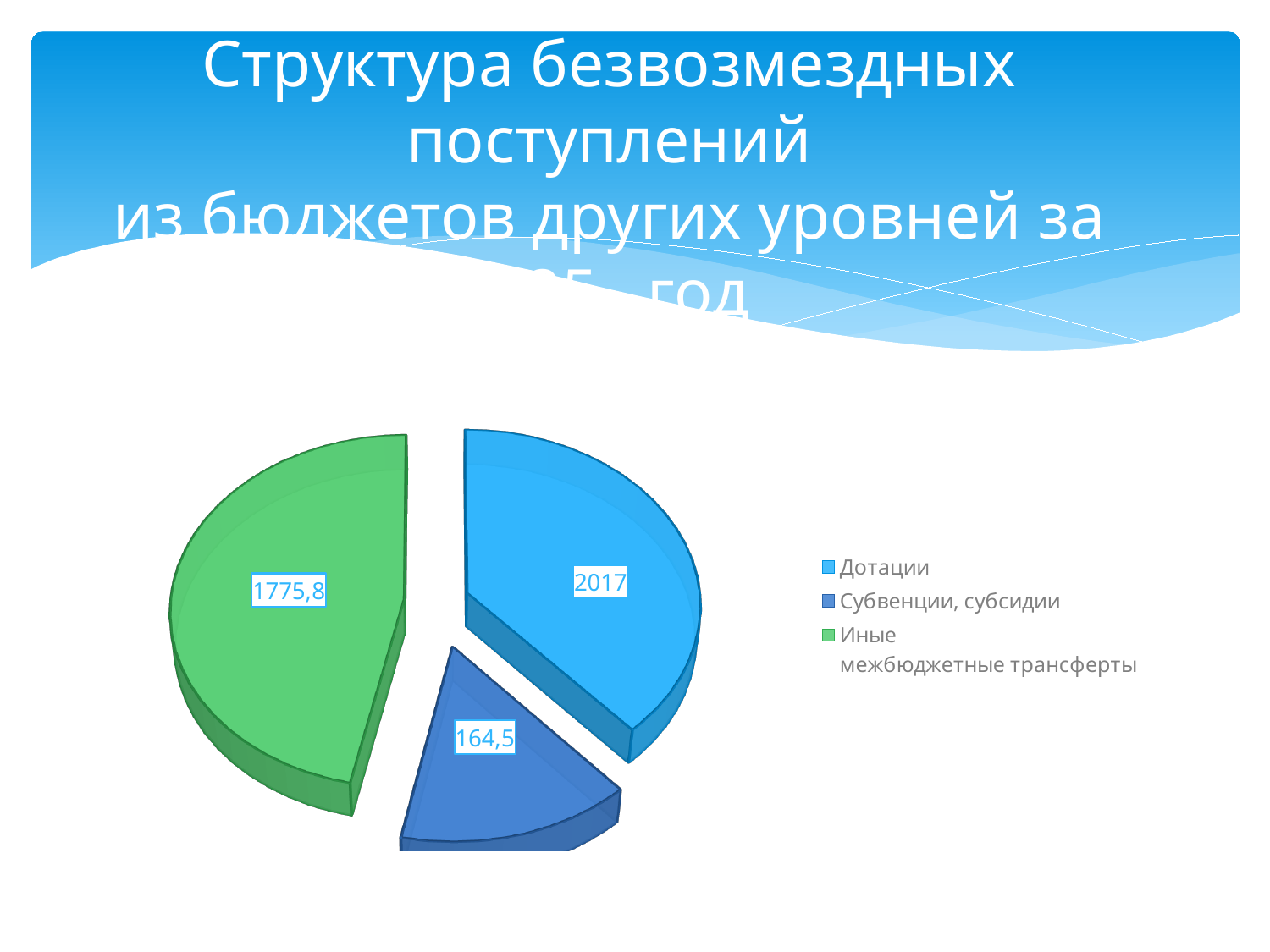
What is the total of all three slices? 3957,3 What is the difference between the values for Дотации and Иные межбюджетные трансферты? 241,2 What is the value for Иные межбюджетные трансферты? 1775,8 What is the value for Дотации? 2017 What is the difference between the values for Дотации and Субвенции, субсидии? 1852,5 What is the value for Субвенции, субсидии? 164,5 How many slices does the pie chart have? 3 What colour is the slice for Иные межбюджетные трансферты? Green What type of chart is shown on the slide? Pie chart Which category has the smallest value? Субвенции, субсидии Which is larger, the value for Иные межбюджетные трансферты or the value for Субвенции, субсидии? Иные межбюджетные трансферты